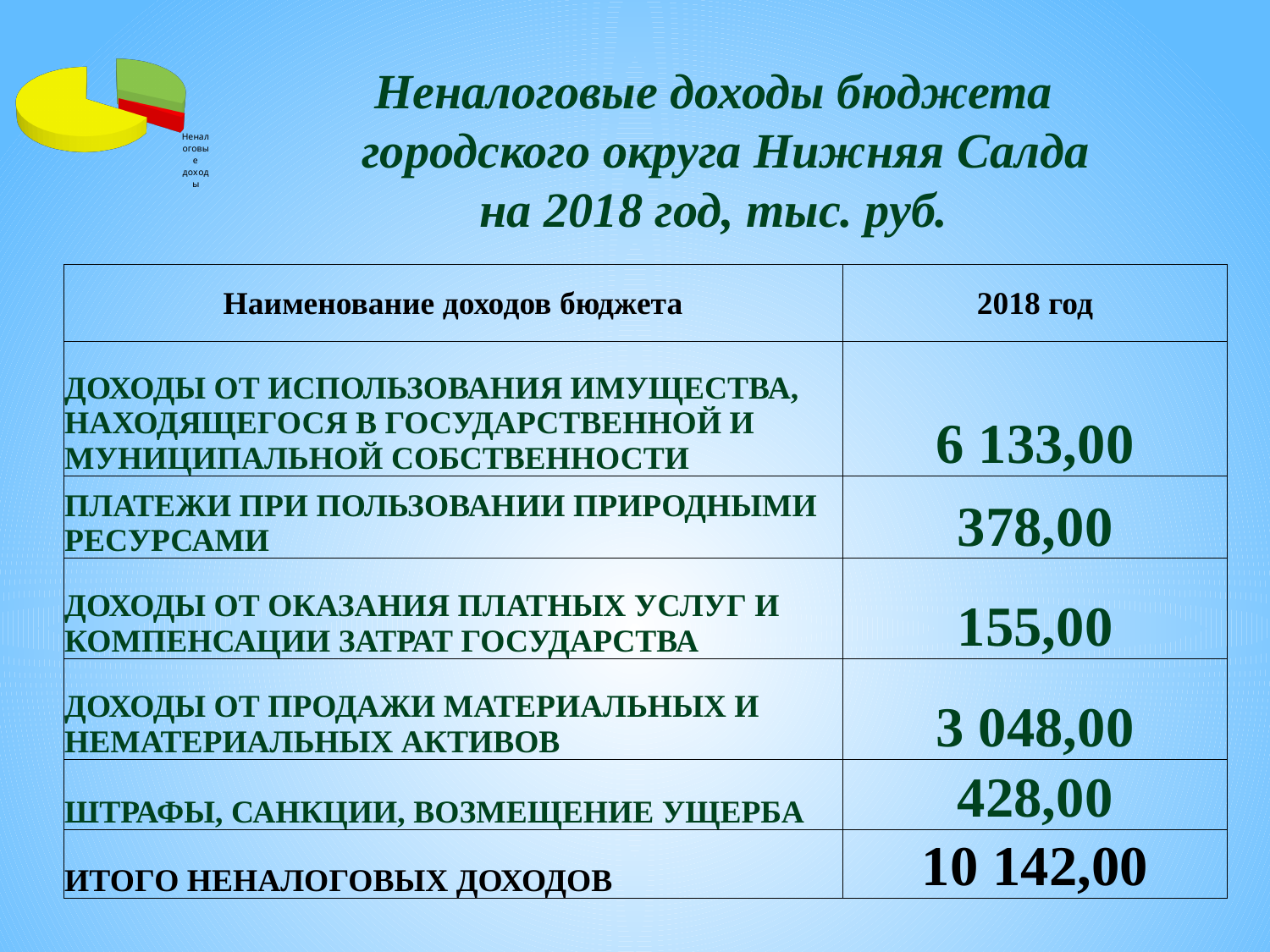
Which colour slice is the largest in the pie chart in the top-left corner? yellow How many slices does the pie chart in the top-left corner have? 3 What kind of chart is shown in the top-left corner of the slide? pie chart In the pie chart in the top-left corner, which slice is larger, the green one or the red one? green In the pie chart in the top-left corner, which slice is larger, the yellow one or the green one? yellow Does the pie chart in the top-left corner show any data labels with values? No Which colour slice is the smallest in the pie chart in the top-left corner? red